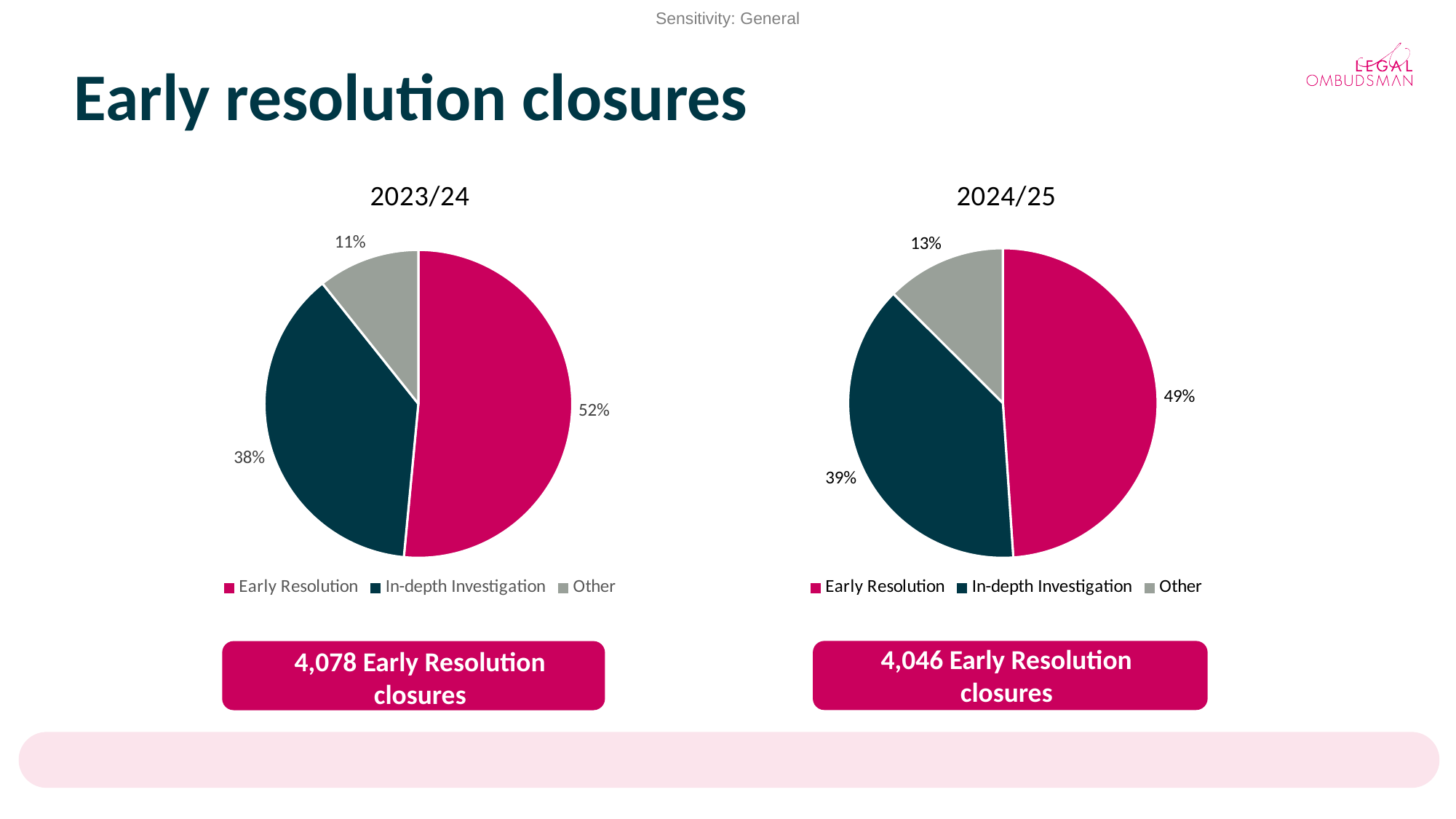
In the 2024/25 pie chart, what share is In-depth Investigation? 39% In the 2023/24 pie chart, what share is Early Resolution? 52% In the 2023/24 pie chart, what is the difference between the Early Resolution and In-depth Investigation shares? 14% In the 2023/24 pie chart, what share is Other? 11% In the 2024/25 pie chart, is the Early Resolution share larger or smaller than the In-depth Investigation share? larger In the 2023/24 pie chart, what colour is the In-depth Investigation slice? dark teal How many categories does the 2023/24 pie chart show? 3 What is the title of the chart on the right of the slide? 2024/25 In the 2023/24 pie chart, which category has the largest share? Early Resolution In the 2024/25 pie chart, which category has the smallest share? Other What kind of chart is the 2024/25 chart? pie chart In the 2024/25 pie chart, what share is Other? 13%